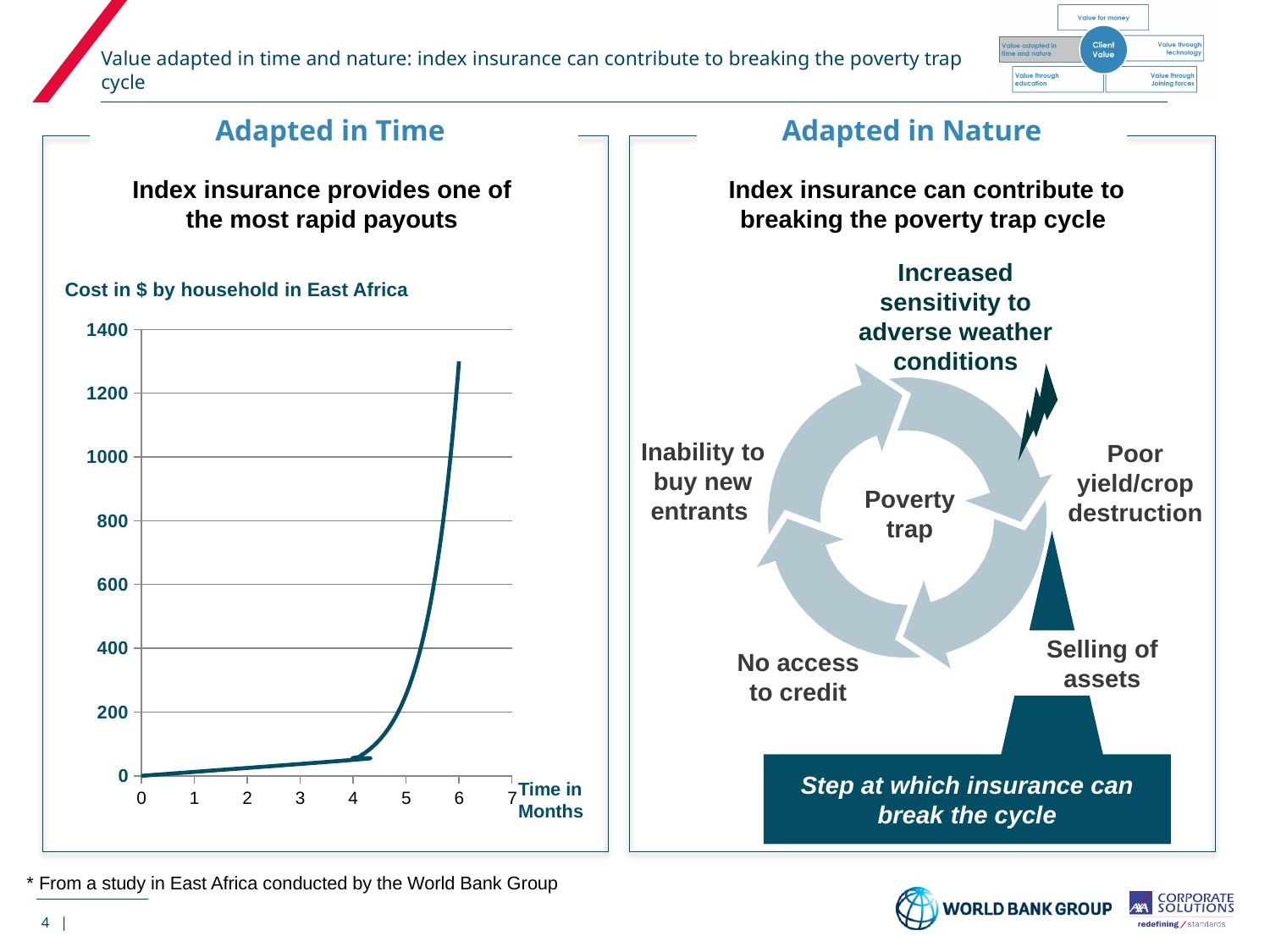
What is the title of the chart on the slide? Cost in $ by household in East Africa Which month shown has the highest cost, month 2 or month 6? month 6 Is the cost at month 2 greater or less than 200? less Is the cost at month 6 greater or less than 1200? greater Is the cost at month 6 greater or less than 1000? greater What kind of chart is shown under "Cost in $ by household in East Africa"? line chart Does the cost in $ by household rise or fall as time in months increases? rise What is the highest value shown on the x axis of the chart? 7 What is the label of the x axis of the chart? Time in Months What is the highest value shown on the y axis of the chart? 1400